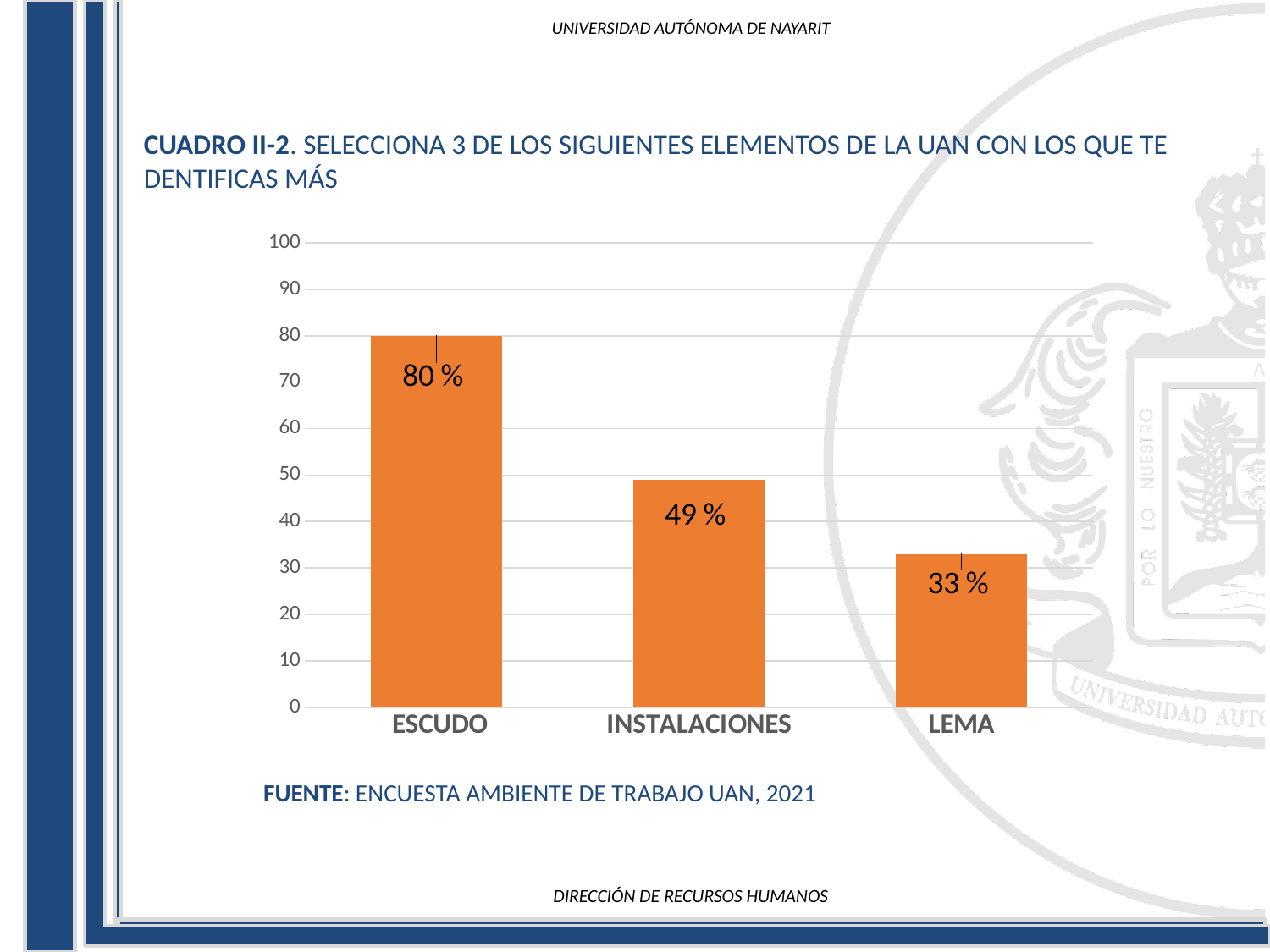
Which category has the lowest value? LEMA What is the source cited below the chart? ENCUESTA AMBIENTE DE TRABAJO UAN, 2021 How many categories are shown in the chart? 3 Which is larger, the value for INSTALACIONES or the value for LEMA? INSTALACIONES What is the value for LEMA? 33 % Which category has the highest value? ESCUDO What is the difference between the values for INSTALACIONES and LEMA? 16 % Is the value for INSTALACIONES greater or less than 50? less What kind of chart is shown on the slide? bar chart What is the value for INSTALACIONES? 49 % What is the difference between the values for ESCUDO and INSTALACIONES? 31 % What is the value for ESCUDO? 80 %